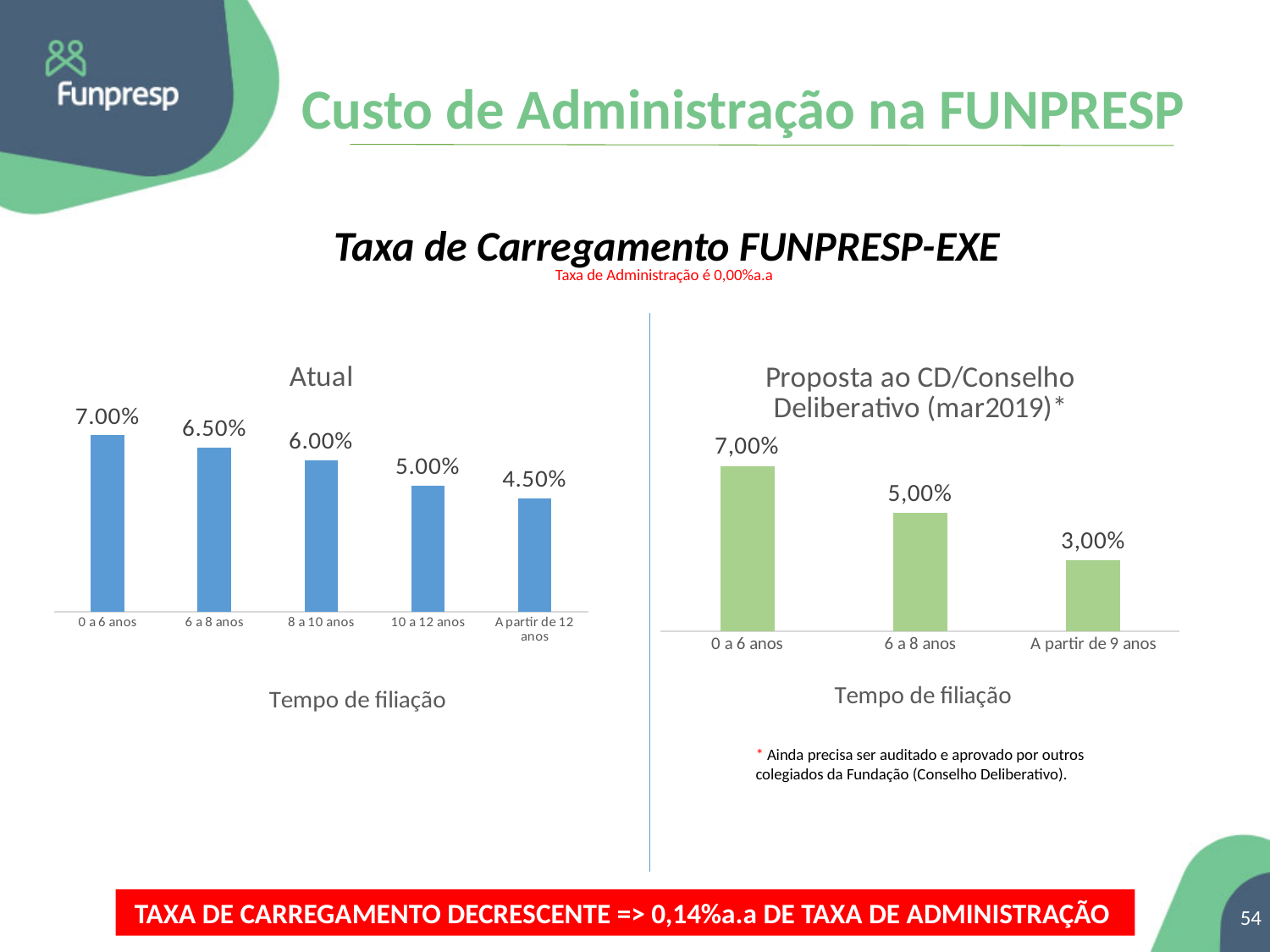
How many categories are shown in the 'Atual' chart? 5 In the 'Atual' chart, which is larger: the value for '6 a 8 anos' or the value for '10 a 12 anos'? 6 a 8 anos In the 'Proposta ao CD/Conselho Deliberativo (mar2019)*' chart, which category has the lowest value? A partir de 9 anos In the 'Proposta ao CD/Conselho Deliberativo (mar2019)*' chart, what is the value for '6 a 8 anos'? 5,00% How many categories are shown in the 'Proposta ao CD/Conselho Deliberativo (mar2019)*' chart? 3 In the 'Proposta ao CD/Conselho Deliberativo (mar2019)*' chart, what is the value for 'A partir de 9 anos'? 3,00% In the 'Proposta ao CD/Conselho Deliberativo (mar2019)*' chart, what is the difference between the values for '0 a 6 anos' and 'A partir de 9 anos'? 4,00% In the 'Atual' chart, which category has the highest value? 0 a 6 anos In the 'Atual' chart, what is the value for 'A partir de 12 anos'? 4.50% In the 'Atual' chart, what is the value for '8 a 10 anos'? 6.00% In the 'Atual' chart, do the values rise or fall from left to right along the x axis? fall In the 'Atual' chart, what is the difference between the values for '0 a 6 anos' and '10 a 12 anos'? 2.00%